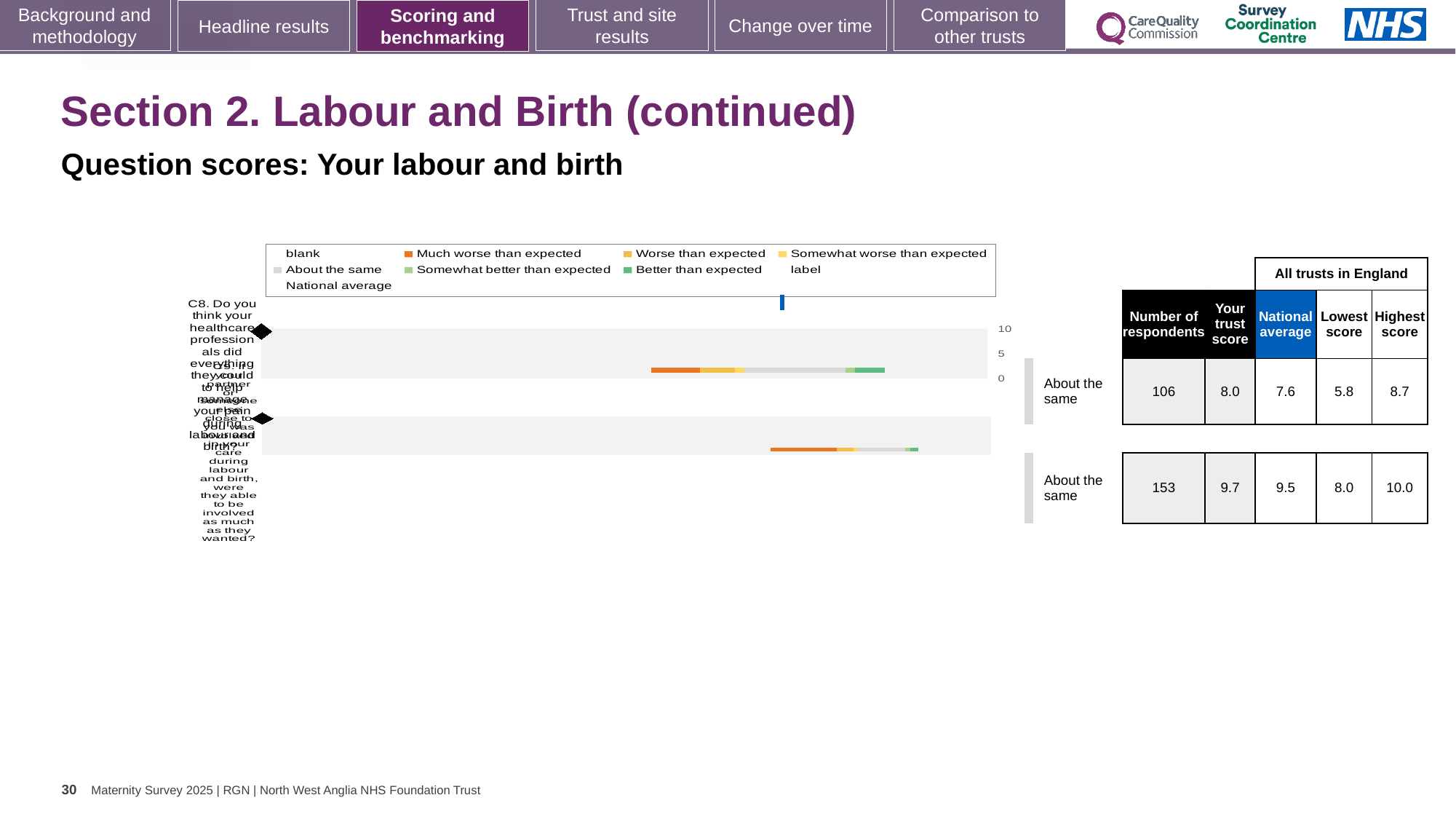
What is the highest score across all trusts in England for the bottom row question? 10.0 What is the lowest score across all trusts in England for the bottom row question? 8.0 Is the trust score for the bottom row question higher or lower than its national average? higher Which row has more respondents, the top row (C8) or the bottom row? the bottom row What is the national average for question C8 (the top row)? 7.6 What is the trust score for question C8 (the top row)? 8.0 By how much does the trust score for question C8 exceed the national average? 0.4 How many entries does the chart legend list? 9 In the table beside the chart, what is the number of respondents for question C8 (the top row)? 106 What kind of chart is shown on the slide? bar chart What benchmark category is shown for question C8? About the same How many question rows are plotted in the chart? 2